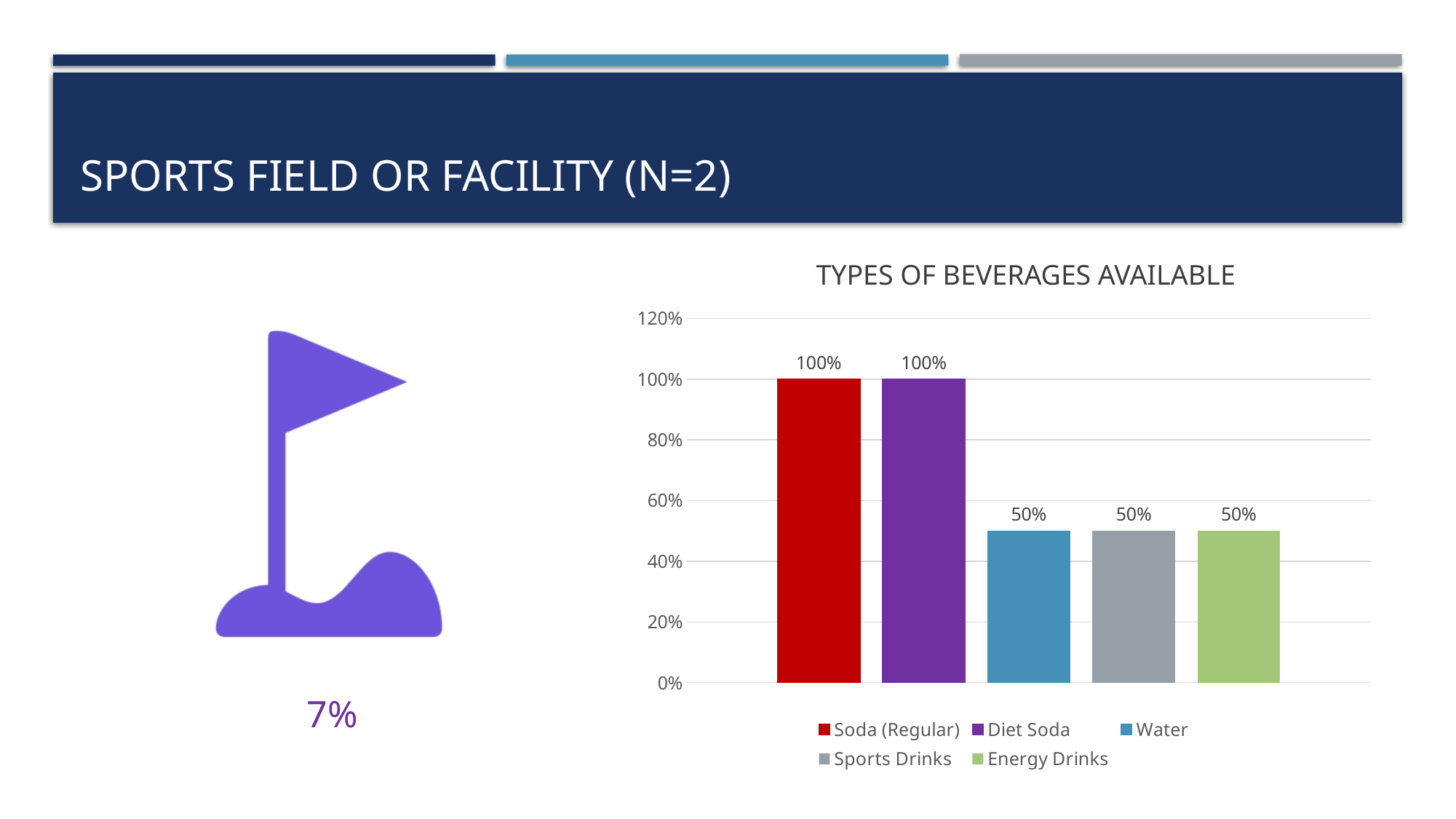
What kind of chart is shown on the slide? Bar chart What is the difference between the values for Soda (Regular) and Water? 50% Is the value for Diet Soda greater or less than 80%? greater Is the value for Sports Drinks greater or less than 80%? less What is the value for Diet Soda in the Types of Beverages Available chart? 100% What is the value for Soda (Regular) in the Types of Beverages Available chart? 100% What is the value for Water in the Types of Beverages Available chart? 50% How many bars are plotted in the Types of Beverages Available chart? 5 Which beverage type has the lowest value in the chart, Diet Soda or Sports Drinks? Sports Drinks How many entries does the legend of the Types of Beverages Available chart list? 5 What is the title of the chart on the slide? Types of Beverages Available What is the value for Energy Drinks in the Types of Beverages Available chart? 50%